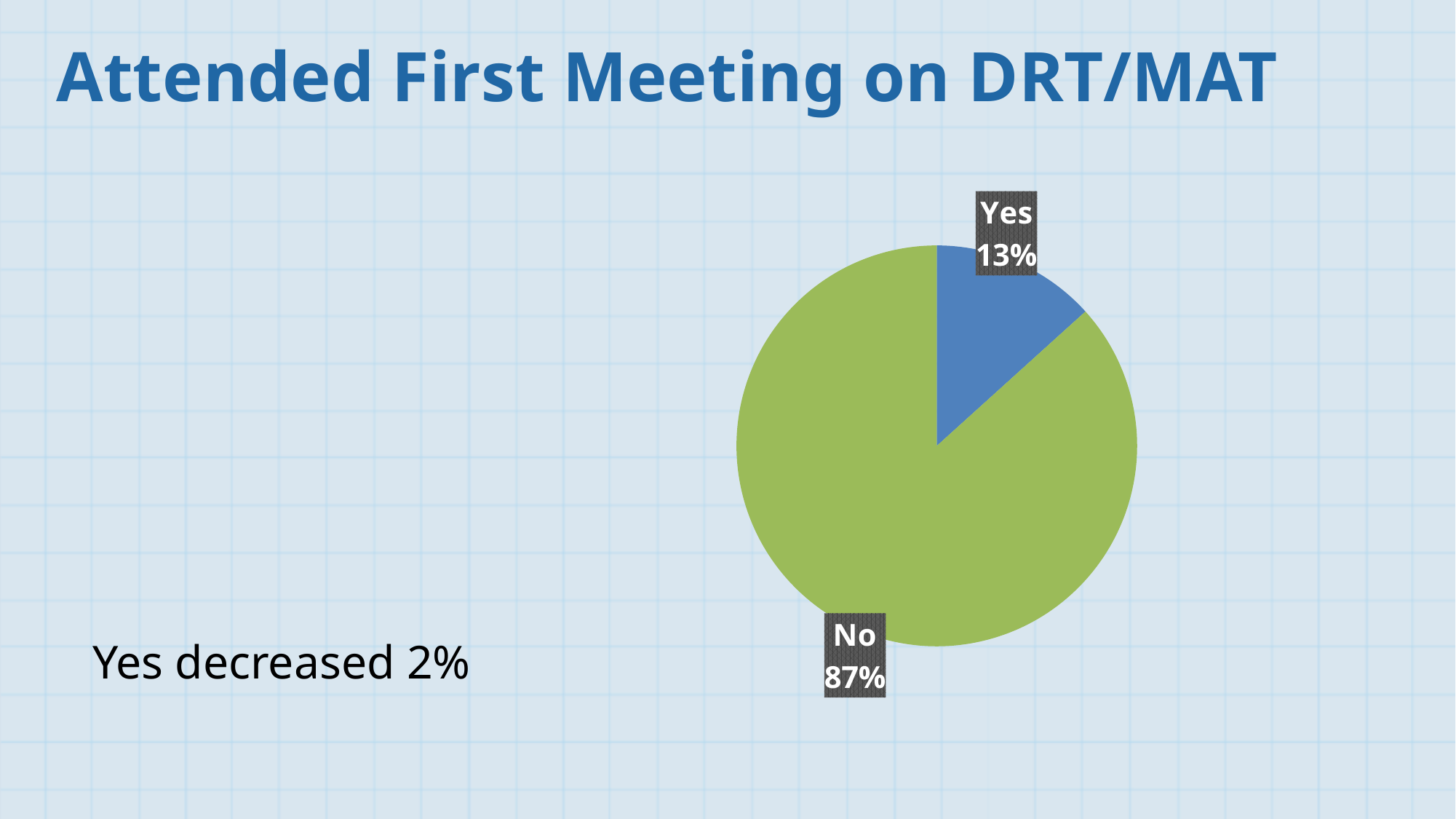
Which slice is larger, "Yes" or "No"? No What kind of chart is shown on the slide? pie chart What percentage of the pie is labelled "No"? 87% What colour is the "Yes" slice of the pie chart? blue Which slice of the pie is the smallest? Yes What is the difference in percentage points between the "No" slice and the "Yes" slice? 74 How many slices does the pie chart have? 2 What is the title of the slide containing the pie chart? Attended First Meeting on DRT/MAT Which slice of the pie is the largest? No According to the text on the slide, by how much did "Yes" decrease? 2% What percentage of the pie is labelled "Yes"? 13% What share of the pie does the "No" slice take up? 87%